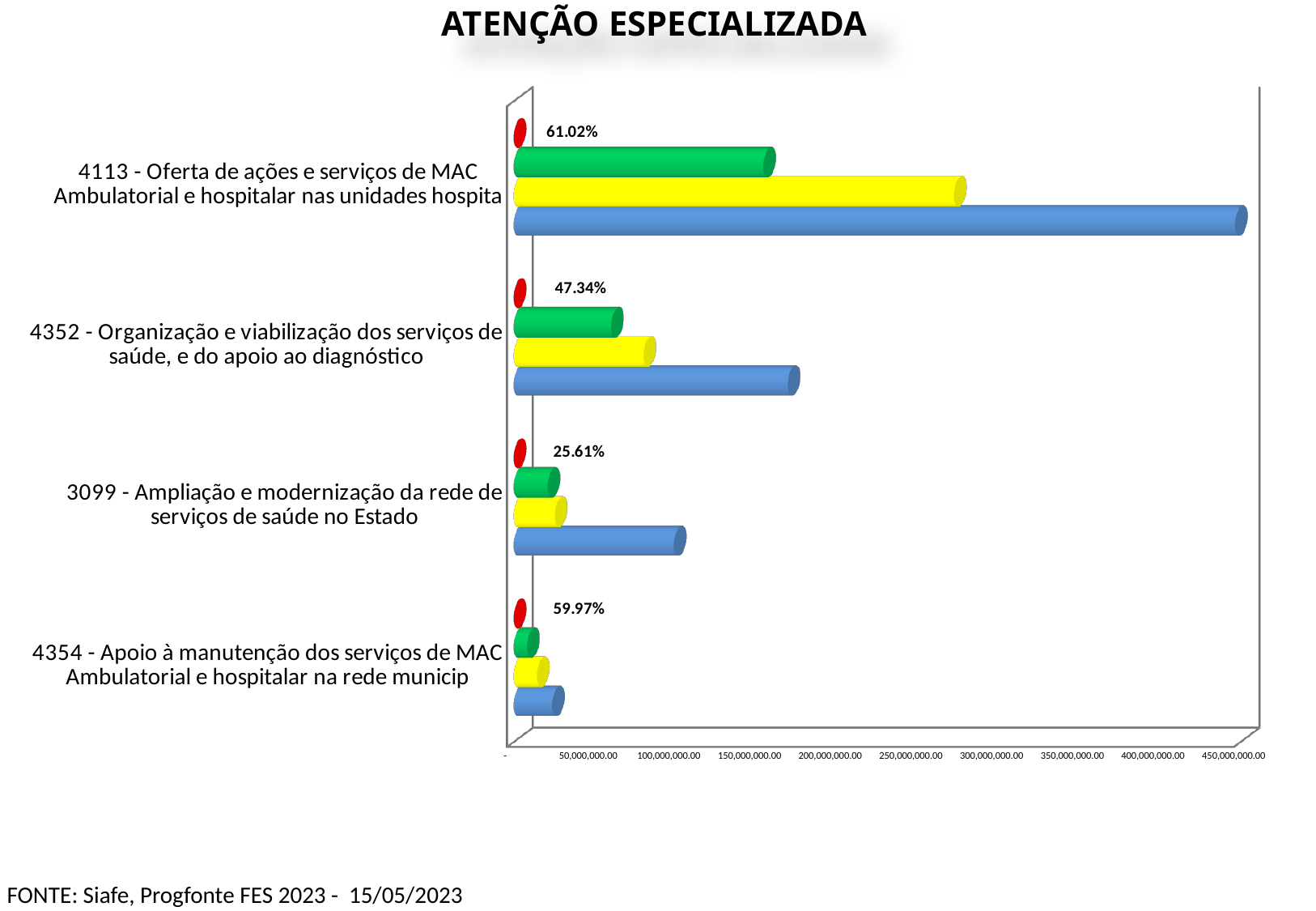
Which has a larger percentage label, category 4352 or category 4354? 4354 - Apoio à manutenção dos serviços de MAC Ambulatorial e hospitalar na rede municip What percentage is shown for the category '3099 - Ampliação e modernização da rede de serviços de saúde no Estado'? 25.61% How many categories are shown on the chart? 4 Is the value of the blue bar for category 4354 greater or less than 50,000,000.00? less Is the value of the blue bar for category 4113 greater or less than 400,000,000.00? greater What percentage is shown for the category '4352 - Organização e viabilização dos serviços de saúde, e do apoio ao diagnóstico'? 47.34% What percentage is shown for the category '4354 - Apoio à manutenção dos serviços de MAC Ambulatorial e hospitalar na rede municip'? 59.97% What type of chart is shown on the slide? Bar chart What is the difference between the percentage labels for category 4113 and category 3099? 35.41% Which category has the lowest percentage label? 3099 - Ampliação e modernização da rede de serviços de saúde no Estado What percentage is shown for the category '4113 - Oferta de ações e serviços de MAC Ambulatorial e hospitalar nas unidades hospita'? 61.02% Which category has the highest percentage label? 4113 - Oferta de ações e serviços de MAC Ambulatorial e hospitalar nas unidades hospita